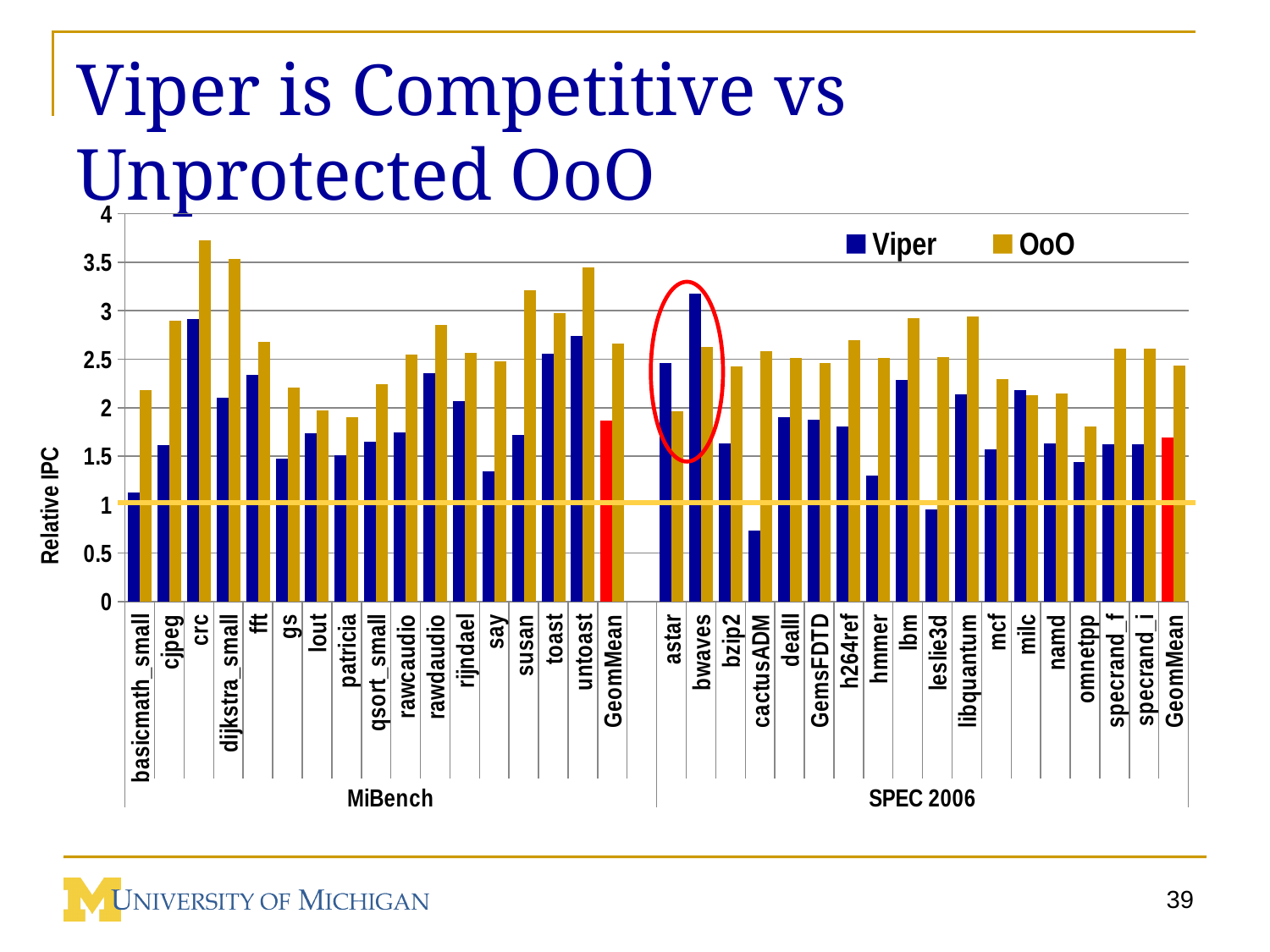
How many benchmark categories (including GeomMean) are shown in the SPEC 2006 group? 18 Which benchmark has the highest OoO bar? crc How many series does the legend list? 2 How many benchmark categories (including GeomMean) are shown in the MiBench group? 17 Is the OoO value for crc greater or less than 3.5? greater What is the label of the y axis? Relative IPC Is the Viper value for cactusADM greater or less than 1? less What are the two series named in the legend? Viper and OoO For bwaves, which is larger, the Viper value or the OoO value? Viper Which benchmark has the highest Viper bar? bwaves What kind of chart is shown on the slide? bar chart Which benchmark has the lowest Viper bar? cactusADM